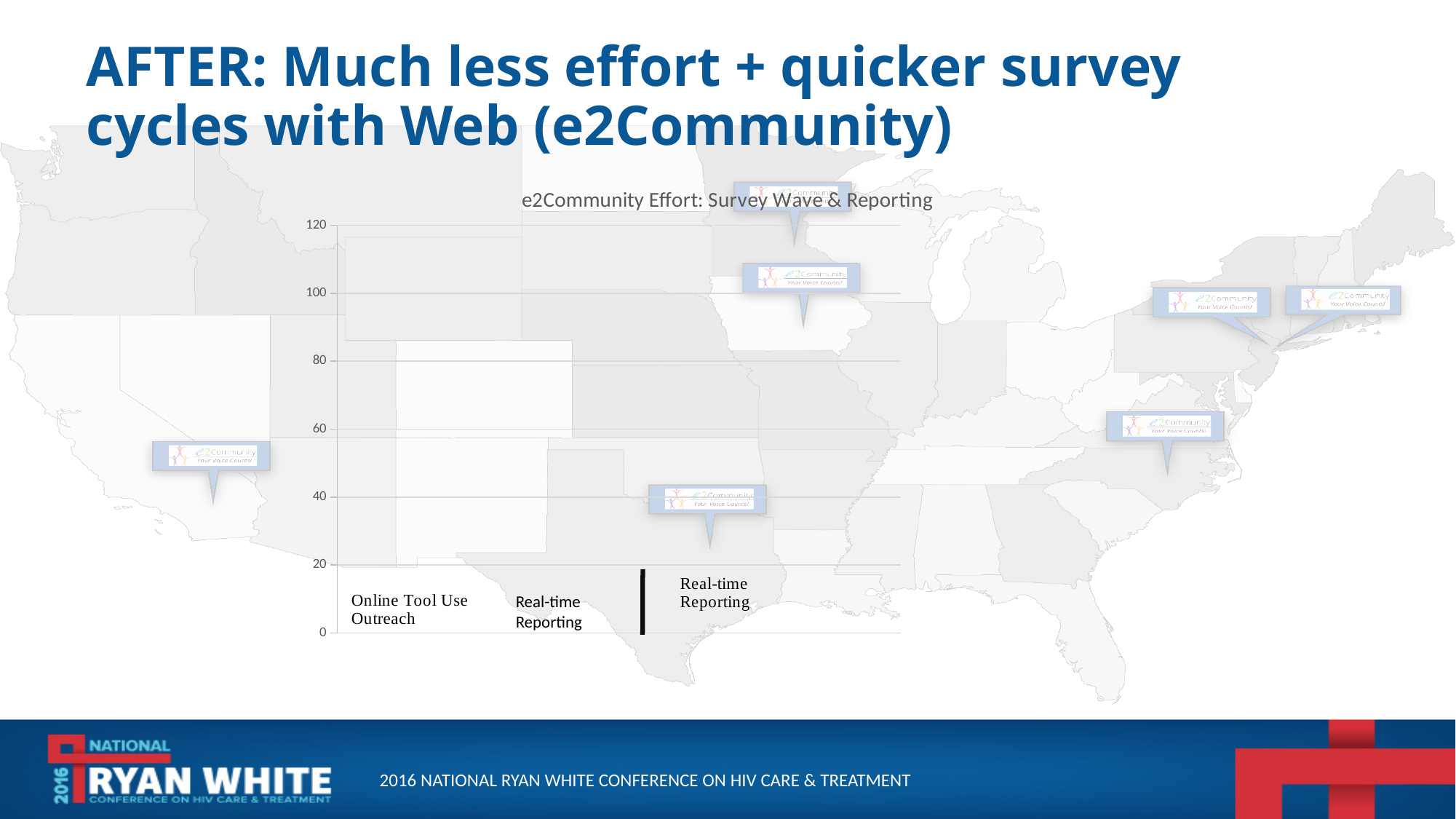
What is the highest value labelled on the chart's vertical axis? 120 Is the value of the black bar in the chart greater or less than 40? less How many bars are plotted in the chart? 1 Is the value of the black bar in the chart greater or less than 20? less What is the title of the chart on the slide? e2Community Effort: Survey Wave & Reporting What kind of chart is shown on the slide? bar chart